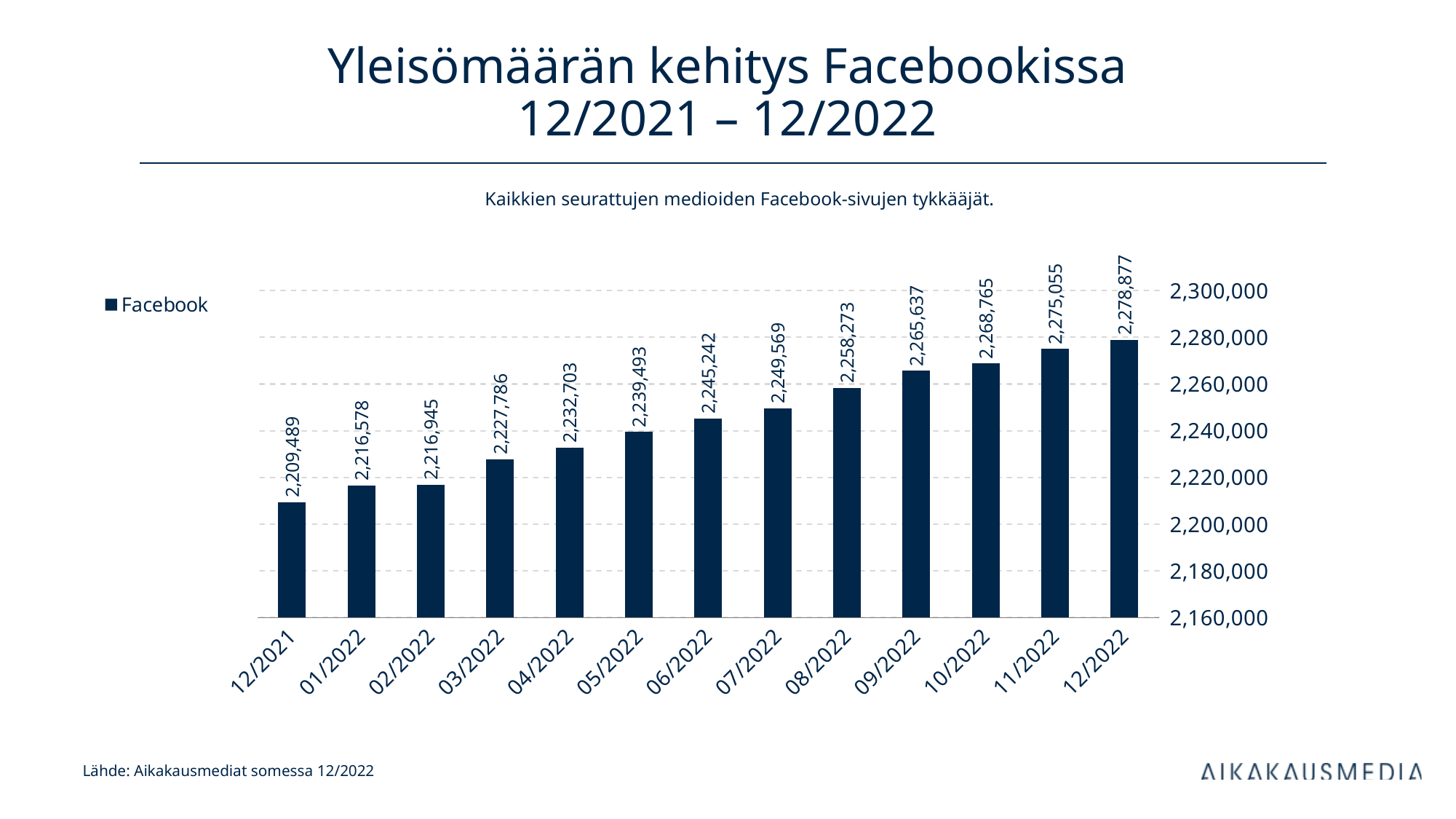
Do the Facebook values rise or fall from 12/2021 to 12/2022? rise What is the Facebook value for 06/2022? 2,245,242 What is the Facebook value for 12/2022? 2,278,877 What kind of chart is shown on the slide? bar chart What is the difference between the Facebook values for 02/2022 and 01/2022? 367 What is the Facebook value for 12/2021? 2,209,489 Which month has the highest Facebook value? 12/2022 Is the Facebook value for 05/2022 greater or less than 2,240,000? less How many months are shown on the x axis? 13 What is the difference between the Facebook values for 12/2022 and 12/2021? 69,388 Which is larger, the Facebook value for 09/2022 or for 08/2022? 09/2022 Which month has the lowest Facebook value? 12/2021